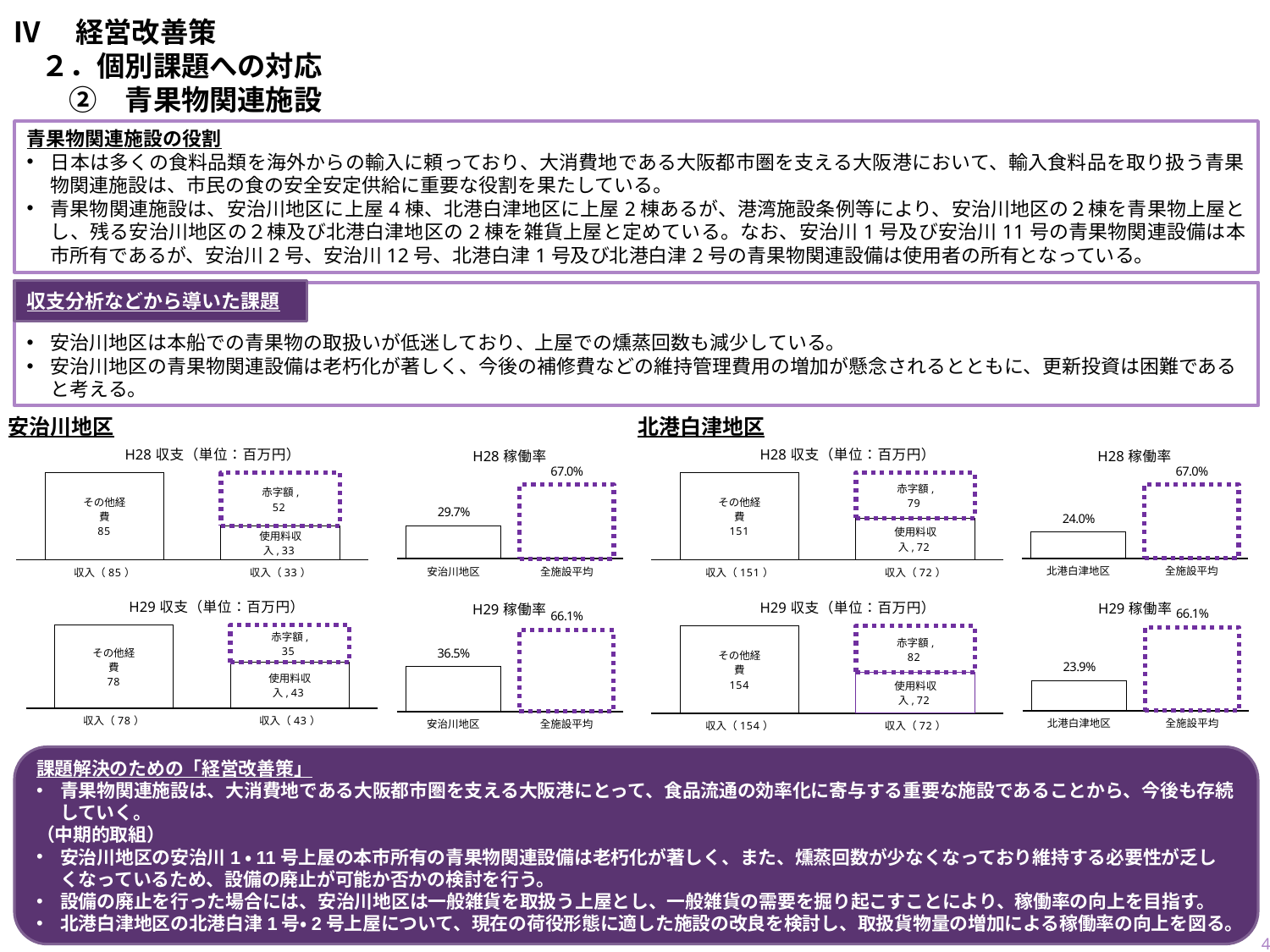
In the 安治川地区 H28 稼働率 chart, what is the value for 安治川地区? 29.7% In the 安治川地区 H29 稼働率 chart, what is the value for 安治川地区? 36.5% In the 北港白津地区 H29 収支 chart, what is the value of その他経費? 154 In the 北港白津地区 H29 稼働率 chart, what is the difference between 全施設平均 and 北港白津地区? 42.2% In the 北港白津地区 H28 稼働率 chart, what is the value for 北港白津地区? 24.0% What type of chart is the 安治川地区 H28 稼働率 chart? Bar chart In the 安治川地区 H28 稼働率 chart, what is the value for 全施設平均? 67.0% In the 安治川地区 H28 収支 chart, what is the value of 赤字額? 52 In the 安治川地区 H29 収支 chart, what is the difference between その他経費 and 使用料収入? 35 In the 北港白津地区 H29 稼働率 chart, which bar is higher, 北港白津地区 or 全施設平均? 全施設平均 In the 安治川地区 H29 収支 chart, what is the value of 使用料収入? 43 In the 北港白津地区 H28 収支 chart, what is the total of the stacked bar made up of 赤字額 and 使用料収入? 151